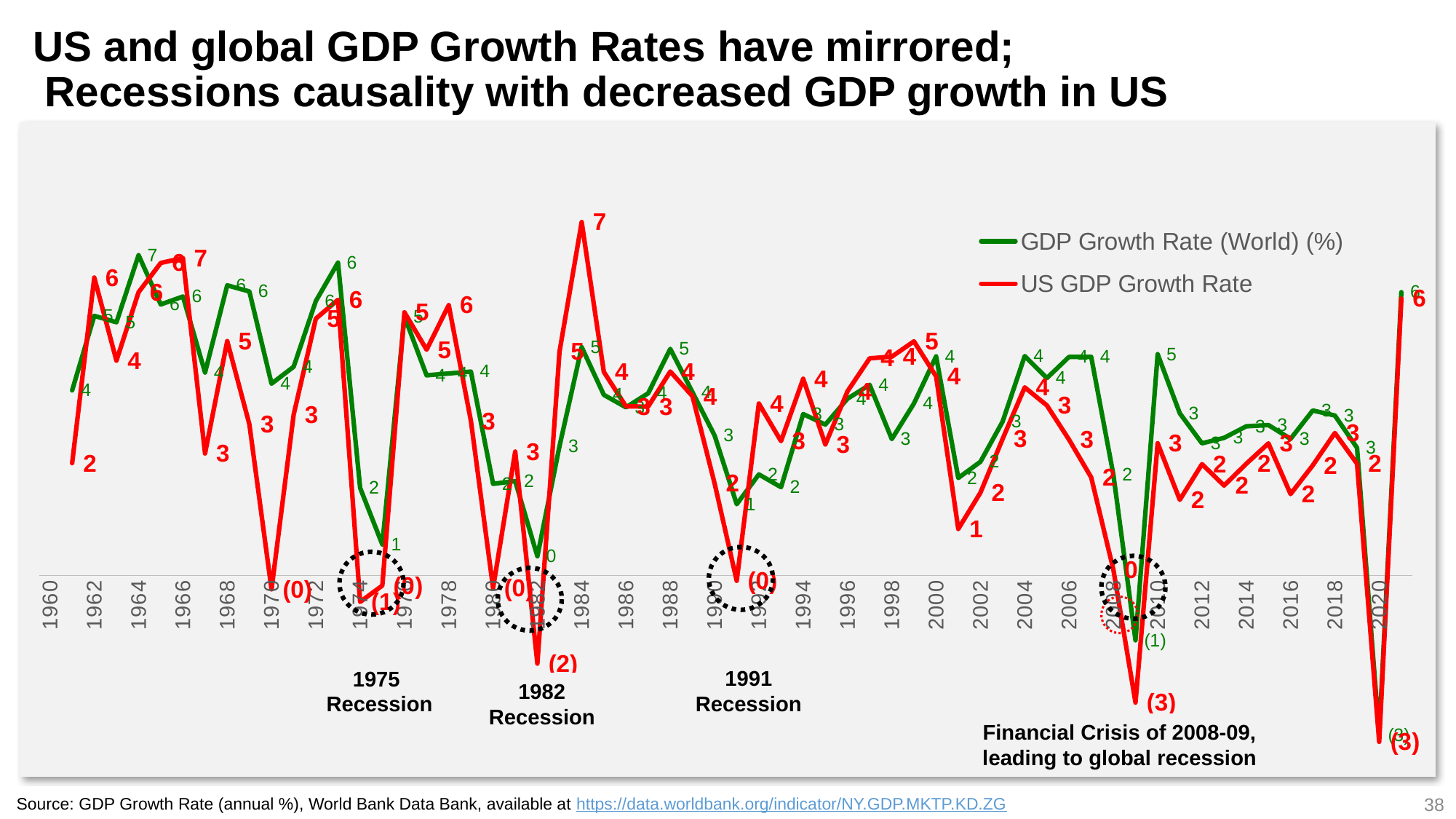
What are the two series named in the chart legend? GDP Growth Rate (World) (%) and US GDP Growth Rate In 2009, which series has the lower value, US GDP Growth Rate or GDP Growth Rate (World)? US GDP Growth Rate Which three recession years are annotated with dotted circles on the chart? 1975, 1982 and 1991 In 1984, which series has the higher value, US GDP Growth Rate or GDP Growth Rate (World)? US GDP Growth Rate How many series does the chart legend list? 2 What is the GDP Growth Rate (World) value labelled for 2009? (1) What kind of chart is shown on the slide? line chart What is the US GDP Growth Rate value labelled for 1984? 7 What is the US GDP Growth Rate value labelled for 2020? (3) What is the US GDP Growth Rate value labelled for 1982? (2) What is the US GDP Growth Rate value labelled for 2021? 6 What is the US GDP Growth Rate value labelled for 2009? (3)